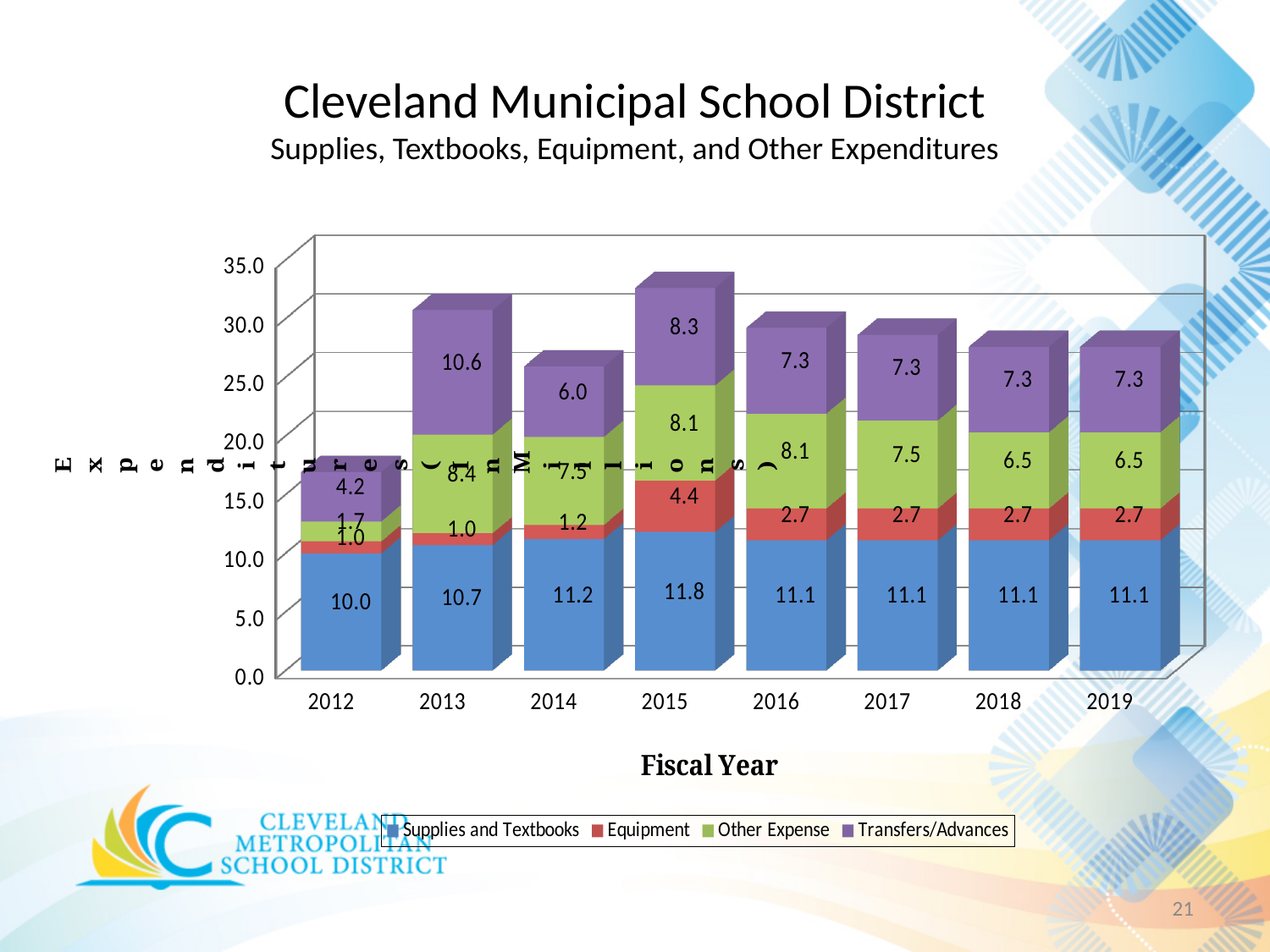
What is the difference between the Transfers/Advances value in 2013 and in 2019? 3.3 What is the value for Supplies and Textbooks in 2015? 11.8 What kind of chart is shown on the slide? Stacked bar chart What is the title of the x axis? Fiscal Year What is the value for Other Expense in 2018? 6.5 How many series does the legend list? 4 Which year has the larger Equipment value, 2015 or 2016? 2015 What is the total of the stacked bar for 2016? 29.2 What is the value for Transfers/Advances in 2013? 10.6 In which fiscal year is the Supplies and Textbooks value highest? 2015 How many fiscal years are shown on the x axis? 8 In which fiscal year is the Supplies and Textbooks value lowest? 2012